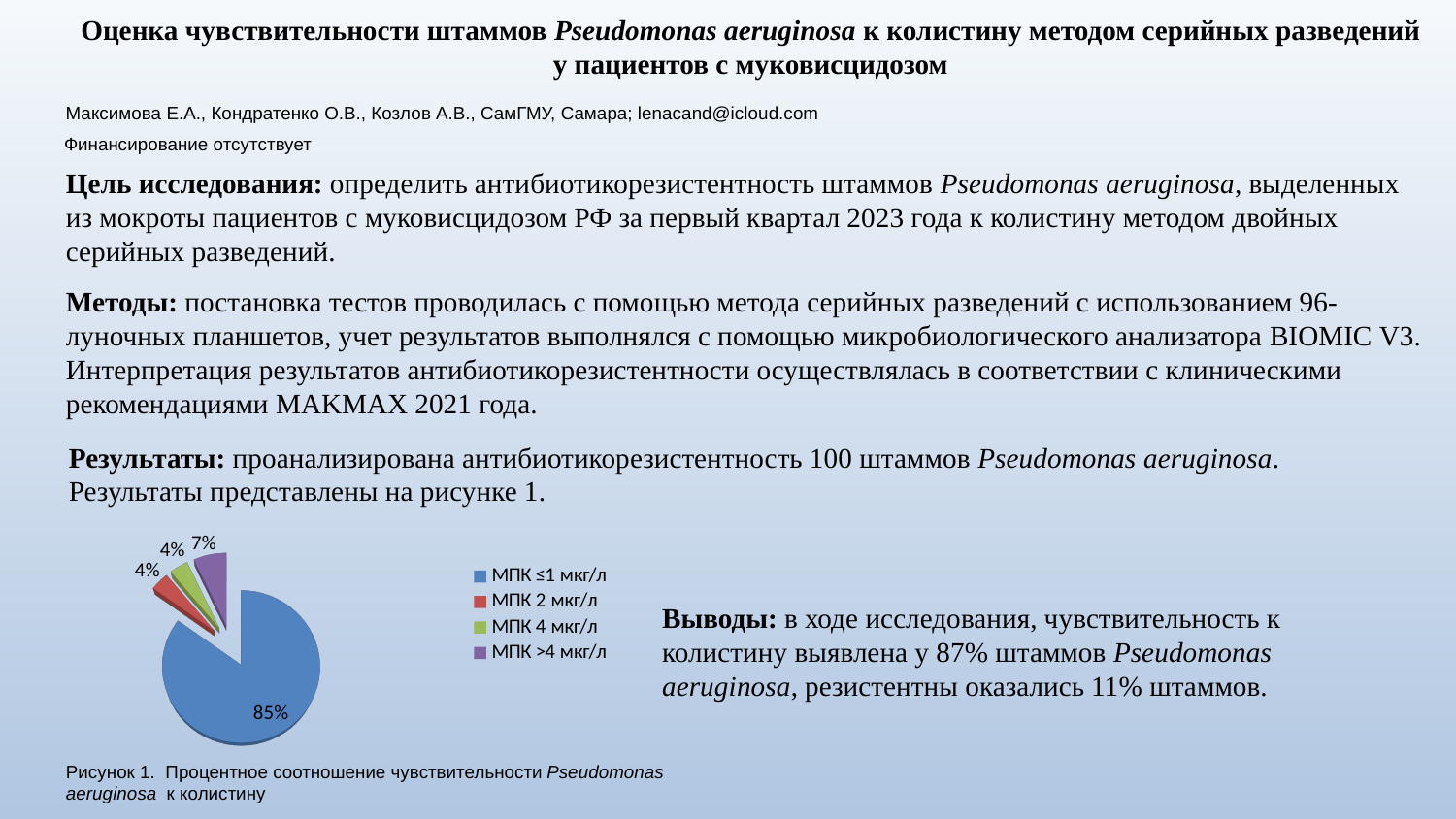
What is the caption of the figure below the pie chart? Рисунок 1. Процентное соотношение чувствительности Pseudomonas aeruginosa к колистину What percentage of strains falls in the МПК 4 мкг/л category? 4% How many entries does the legend of the pie chart list? 4 What percentage of strains falls in the МПК ≤1 мкг/л category? 85% What percentage of strains falls in the МПК >4 мкг/л category? 7% Which is larger, the share for МПК >4 мкг/л or the share for МПК 2 мкг/л? МПК >4 мкг/л What percentage of strains falls in the МПК 2 мкг/л category? 4% What is the difference between the share for МПК ≤1 мкг/л and the share for МПК >4 мкг/л? 78% What colour is the slice for МПК ≤1 мкг/л? blue How many slices does the pie chart have? 4 What kind of chart is shown on the slide? pie chart Which category has the largest share of the pie? МПК ≤1 мкг/л